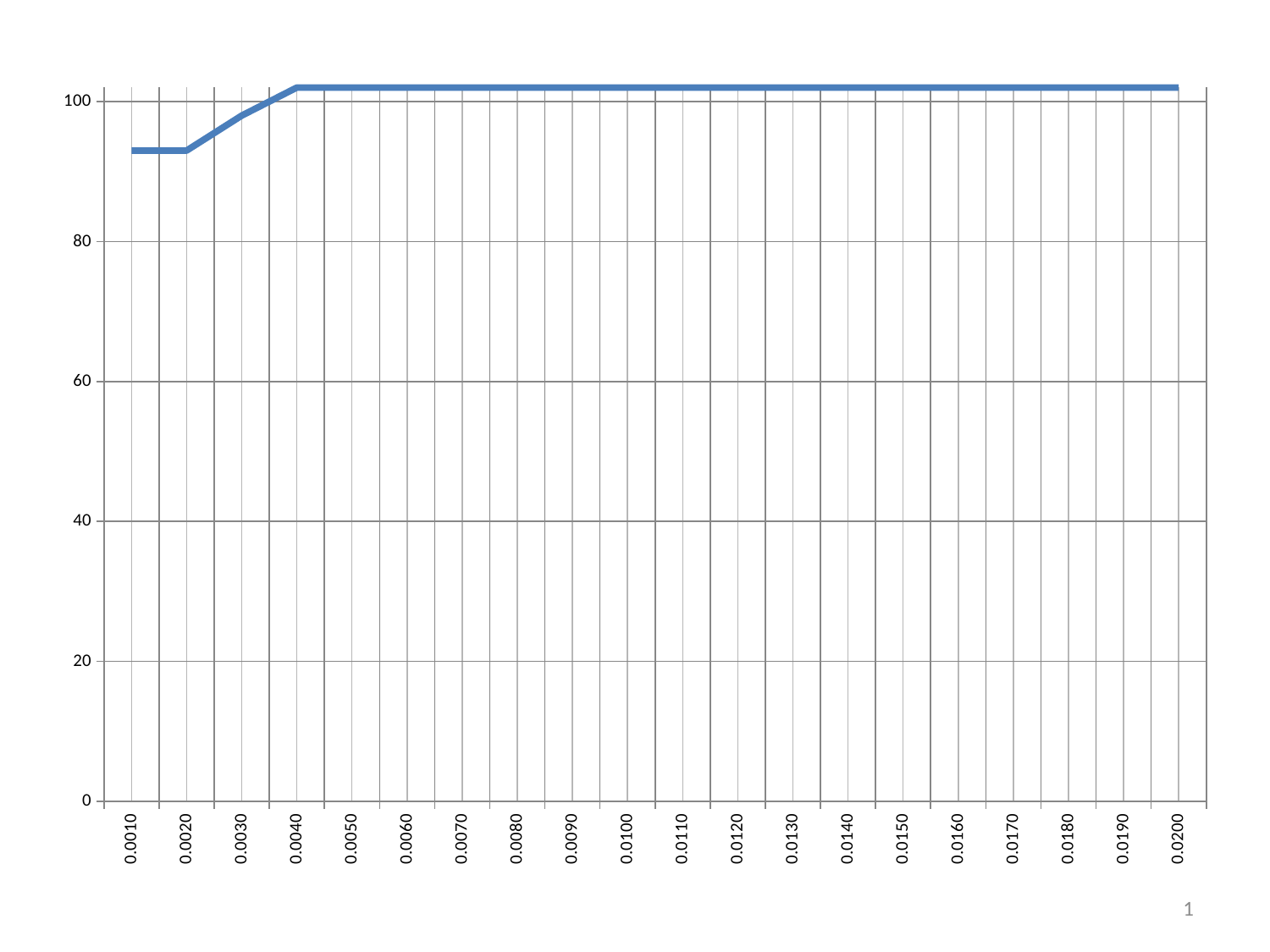
Which has the larger value, 0.0010 or 0.0100? 0.0100 What is the highest labelled tick on the y-axis? 100 Do the values rise or fall from 0.0010 to 0.0040? rise How many x-axis categories are shown on the chart? 20 Is the value at 0.0010 greater or less than 100? less Is the value at 0.0010 greater or less than 80? greater What colour is the plotted line? blue Which has the larger value, 0.0020 or 0.0050? 0.0050 Between 0.0050 and 0.0200, do the values rise, fall, or stay flat? stay flat Is the value at 0.0020 greater or less than 100? less What kind of chart is shown on the slide? line chart